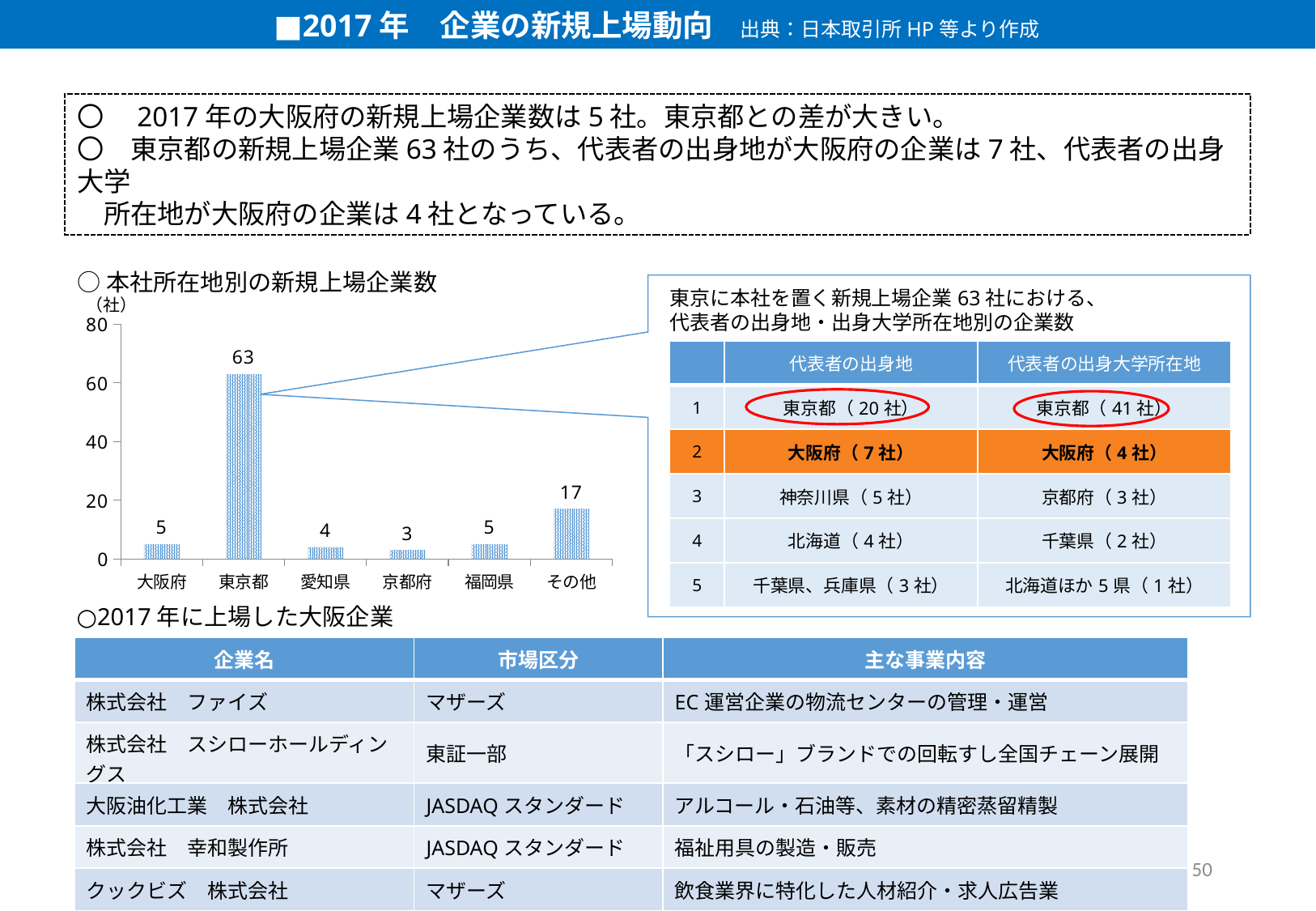
In the bar chart 本社所在地別の新規上場企業数, what is the value for 東京都? 63 How many categories are shown on the x axis of the bar chart 本社所在地別の新規上場企業数? 6 In the bar chart 本社所在地別の新規上場企業数, what is the value for その他? 17 In the bar chart 本社所在地別の新規上場企業数, what is the value for 大阪府? 5 What type of chart is used to show the number of newly listed companies by head office location (本社所在地別の新規上場企業数)? bar chart In the bar chart 本社所在地別の新規上場企業数, which category has the lowest value? 京都府 In the bar chart 本社所在地別の新規上場企業数, what is the difference between the values for 東京都 and 大阪府? 58 In the bar chart 本社所在地別の新規上場企業数, which is larger, the value for その他 or the value for 福岡県? その他 In the bar chart 本社所在地別の新規上場企業数, is the value for 東京都 greater or less than 60? greater In the bar chart 本社所在地別の新規上場企業数, which category has the highest value? 東京都 In the bar chart 本社所在地別の新規上場企業数, what is the value for 愛知県? 4 What unit is shown on the y axis of the bar chart 本社所在地別の新規上場企業数? 社